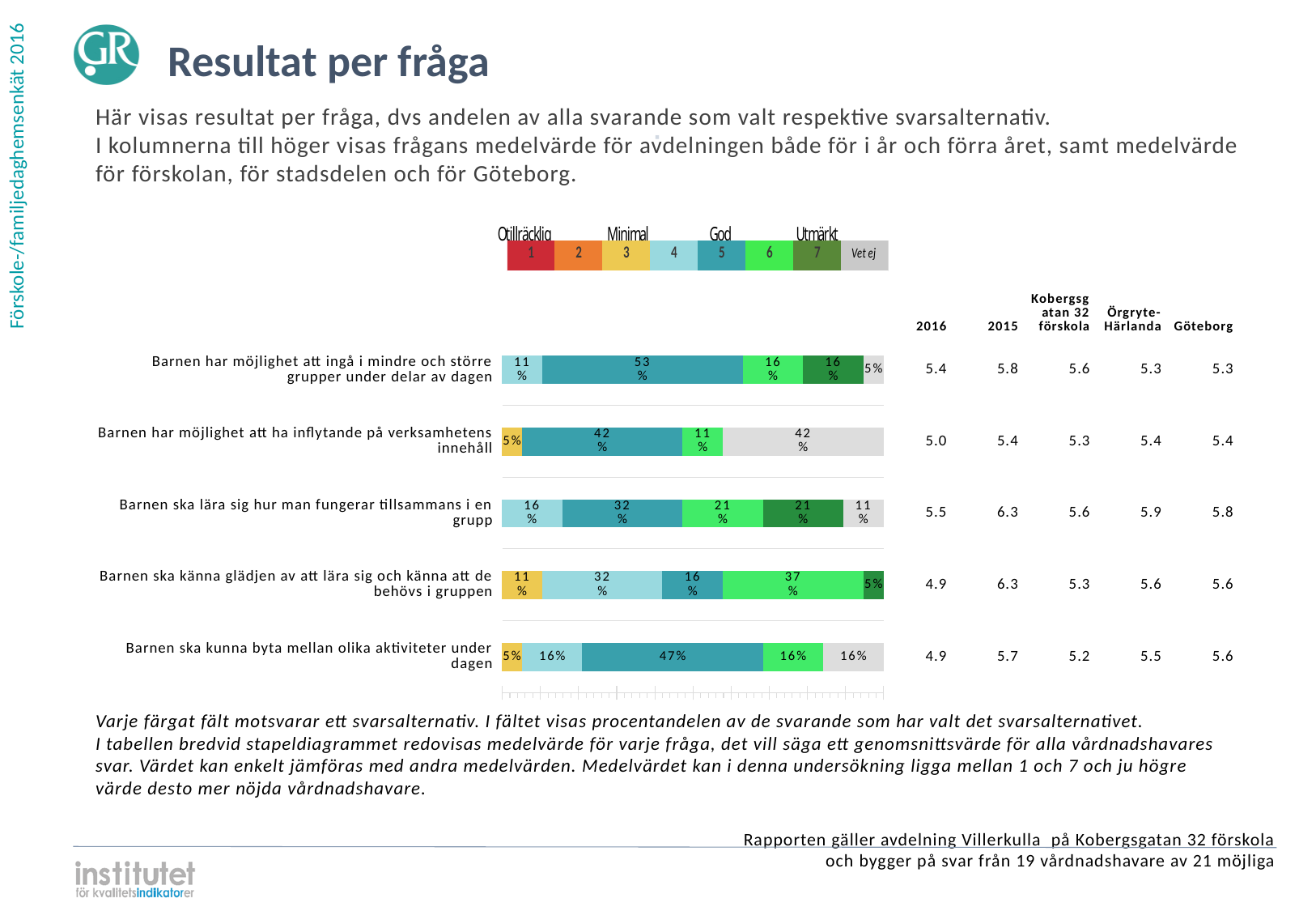
What percentage of respondents answered 'Vet ej' for 'Barnen har möjlighet att ha inflytande på verksamhetens innehåll'? 42% What percentage of respondents chose option 6 (bright green) for 'Barnen ska känna glädjen av att lära sig och känna att de behövs i gruppen'? 37% What is the difference between the option 5 share (53%) and the option 4 share (11%) for 'Barnen har möjlighet att ingå i mindre och större grupper under delar av dagen'? 42 percentage points What percentage of respondents chose option 5 (teal) for 'Barnen ska kunna byta mellan olika aktiviteter under dagen'? 47% What percentage of respondents chose option 5 (teal) for 'Barnen har möjlighet att ingå i mindre och större grupper under delar av dagen'? 53% What is the 2016 mean value for 'Barnen ska lära sig hur man fungerar tillsammans i en grupp'? 5.5 For 'Barnen ska känna glädjen av att lära sig och känna att de behövs i gruppen', which is larger: the share for option 4 (light blue) or option 5 (teal)? option 4 (32%) How many response categories does the legend above the chart list? 8 Which response option has the largest share for 'Barnen ska lära sig hur man fungerar tillsammans i en grupp'? 5 (32%) What label does the legend give to response option 7? Utmärkt How many questions (bars) are shown in the stacked bar chart? 5 What type of chart is shown on the slide? bar chart